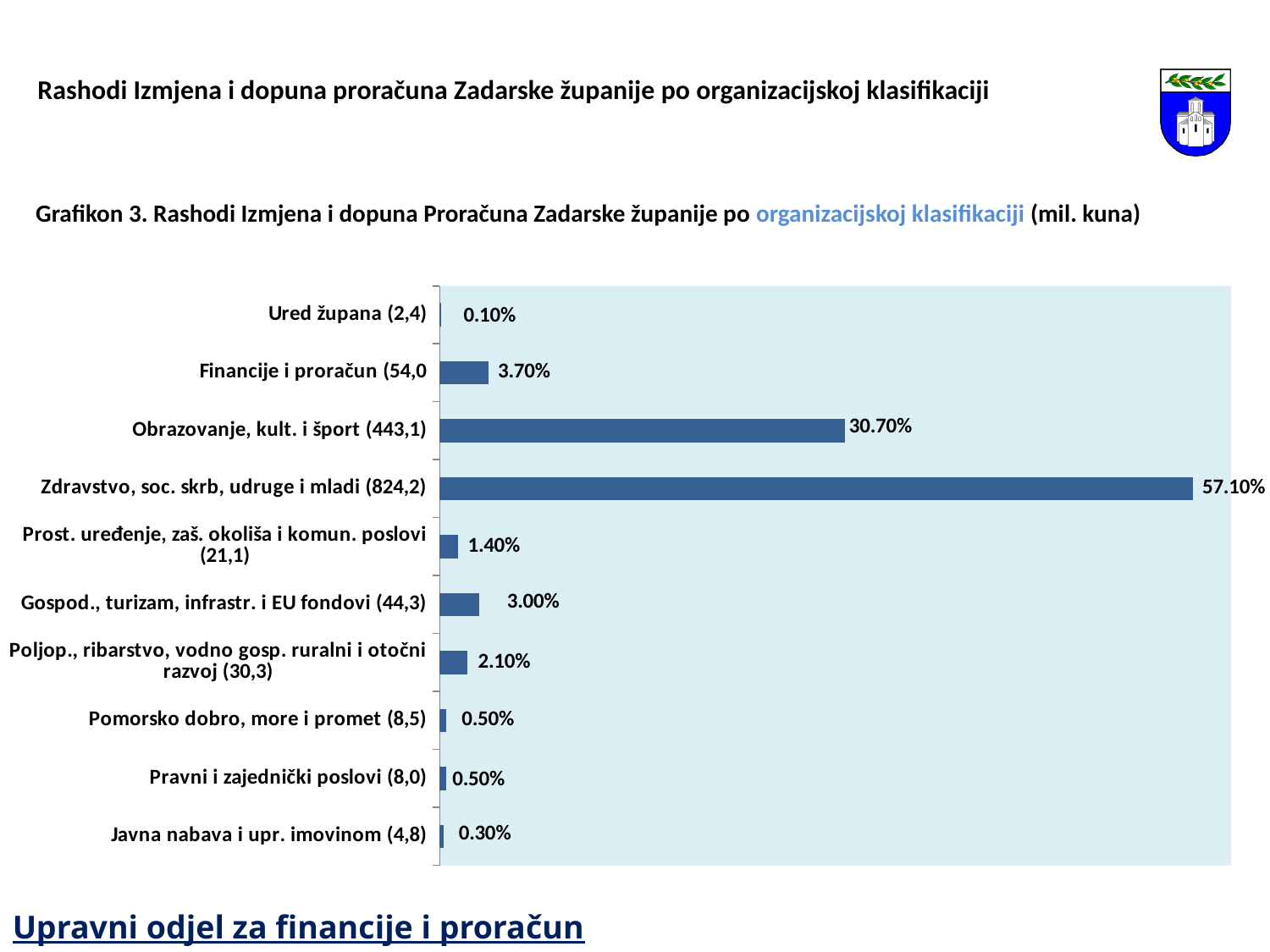
Which category has the lowest value? Ured župana What is the value shown for Javna nabava i upr. imovinom? 0.30% What kind of chart is shown on the slide? bar chart What is the difference between the values for Zdravstvo, soc. skrb, udruge i mladi and Obrazovanje, kult. i šport? 26.40% What is the value shown for Zdravstvo, soc. skrb, udruge i mladi? 57.10% What is the value shown for Financije i proračun? 3.70% Which is larger, the value for Financije i proračun or the value for Gospod., turizam, infrastr. i EU fondovi? Financije i proračun How many categories are plotted in the chart? 10 What is the value shown for Obrazovanje, kult. i šport? 30.70% What is the value shown for Poljop., ribarstvo, vodno gosp. ruralni i otočni razvoj? 2.10% Which category has the highest value? Zdravstvo, soc. skrb, udruge i mladi What unit is stated in parentheses in the chart title (Grafikon 3)? mil. kuna